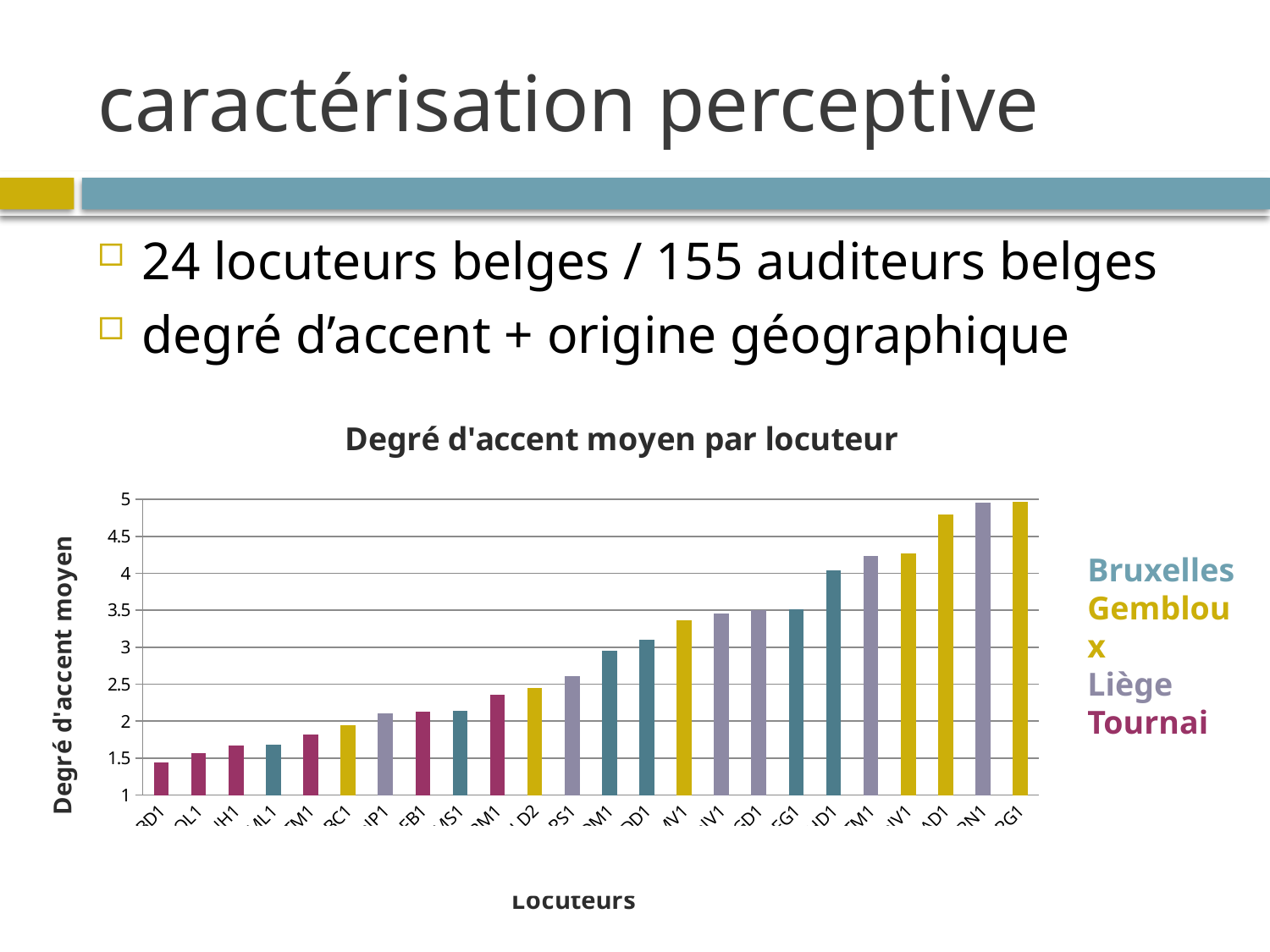
Is the value of the shortest bar greater or less than 3? less Is the value of the leftmost bar greater or less than 2? less Which four regions are listed in the chart's colour key? Bruxelles, Gembloux, Liège, Tournai What is the title of the chart? Degré d'accent moyen par locuteur What kind of chart is shown on the slide? bar chart Is the value of the rightmost bar greater or less than 4.5? greater Is the rightmost bar taller or shorter than the leftmost bar? taller How many bars (locuteurs) are plotted in the chart? 24 Do the bar values rise or fall from left to right along the x axis? rise